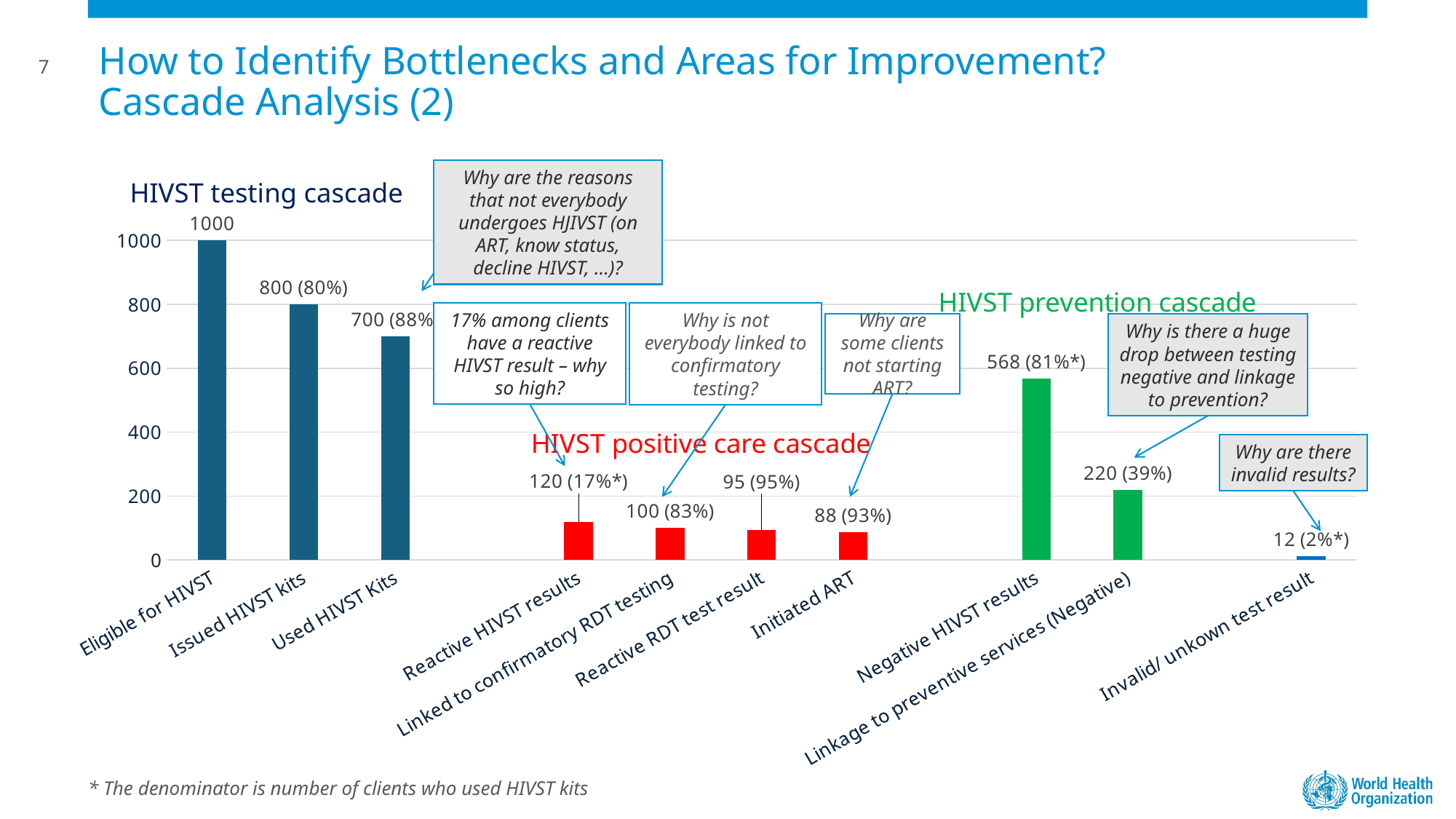
What data label is shown for Issued HIVST kits? 800 (80%) What percentage is shown for Linkage to preventive services (Negative)? 39% What value is shown for Eligible for HIVST? 1000 What kind of chart is shown on the slide? bar chart Which category has the lowest bar? Invalid/ unkown test result Is the value for Linkage to preventive services (Negative) greater or less than 400? less What data label is shown for Negative HIVST results? 568 (81%*) Which category has the highest bar? Eligible for HIVST How many categories are shown on the x axis? 10 What data label is shown for Initiated ART? 88 (93%) Which is larger: Negative HIVST results or Linkage to preventive services (Negative)? Negative HIVST results What is the difference between the number Eligible for HIVST and the number Issued HIVST kits? 200